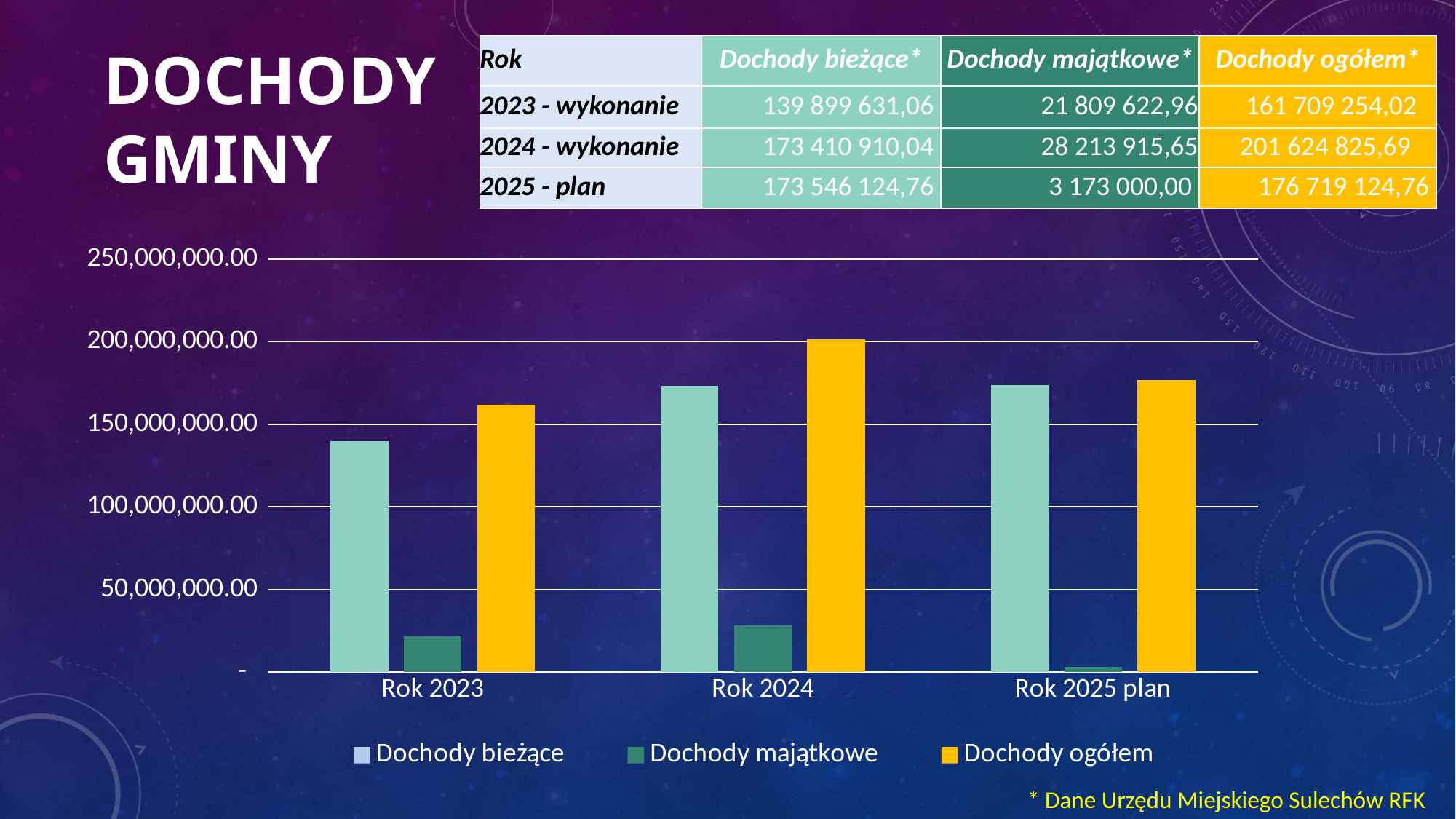
What kind of chart is shown on the slide? bar chart Which is larger: Dochody majątkowe for Rok 2023 or for Rok 2024? Rok 2024 Which year has the highest Dochody ogółem? Rok 2024 How many year categories are shown on the x axis of the chart? 3 How many series does the chart legend list? 3 What is the value of Dochody majątkowe for Rok 2025 plan? 3 173 000,00 Is the value of Dochody bieżące for Rok 2023 greater or less than 150,000,000.00? less Does Dochody majątkowe rise or fall from Rok 2024 to Rok 2025 plan? fall Which year has the lowest Dochody majątkowe? Rok 2025 plan What is the value of Dochody ogółem for Rok 2024? 201 624 825,69 What is the difference between Dochody ogółem for Rok 2024 and Rok 2023? 39 915 571,67 What colour represents Dochody ogółem in the chart? yellow